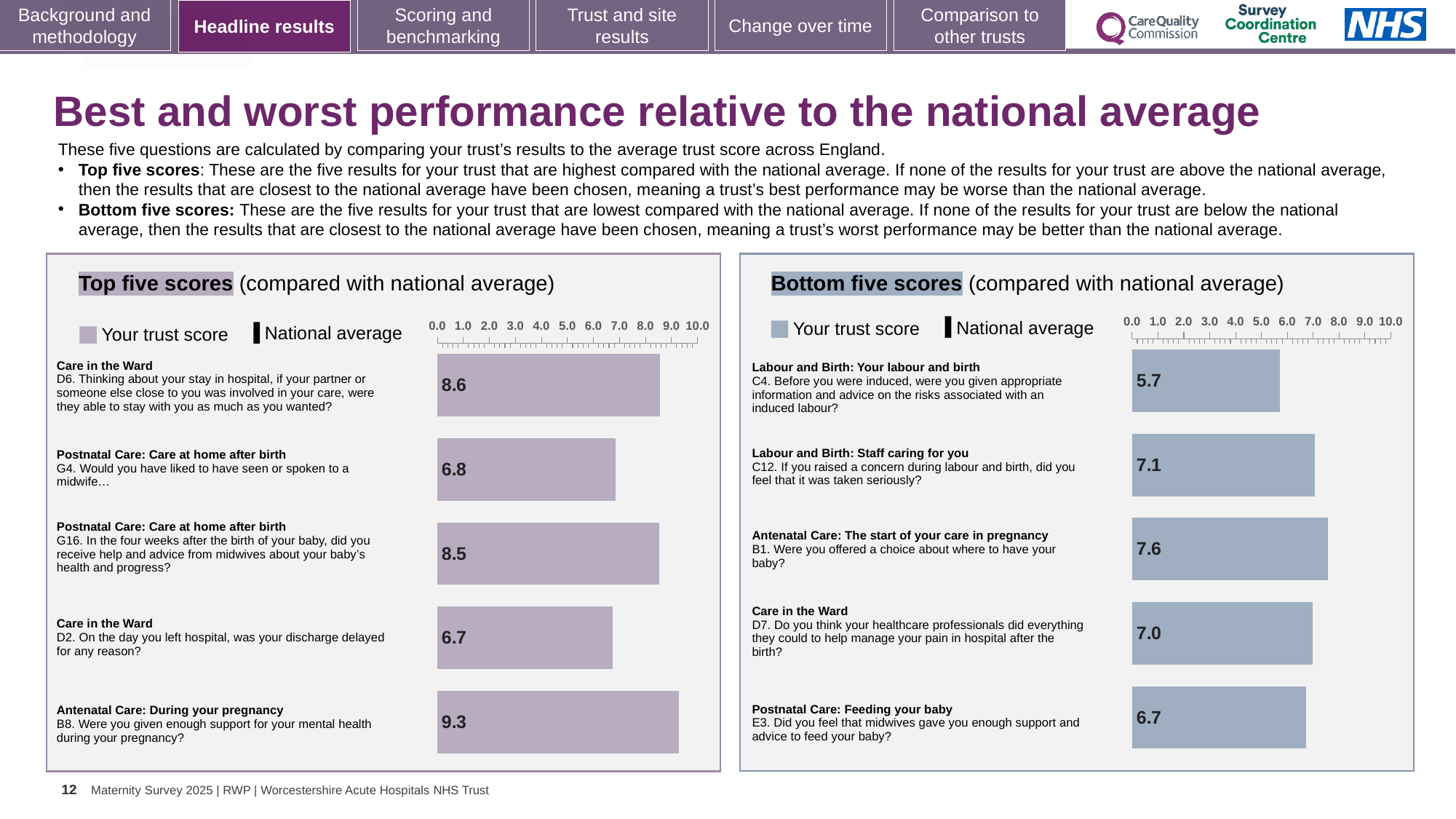
How many series does the legend of the Top five scores chart list? 2 What type of chart is used in the Bottom five scores panel? Bar chart In the Bottom five scores chart, what is the trust score for question C4 about information on the risks of induced labour? 5.7 In the Top five scores chart, what is the trust score for question B8 about support for mental health during pregnancy? 9.3 In the Top five scores chart, which question has the highest trust score? B8. Were you given enough support for your mental health during your pregnancy? In the Bottom five scores chart, which has the larger trust score: C12 or D7? C12 In the Bottom five scores chart, what is the trust score for question E3 about support and advice to feed your baby? 6.7 In the Bottom five scores chart, what is the difference between the trust scores for B1 and C4? 1.9 In the Top five scores chart, what is the trust score for question D6 about a partner being able to stay with you in hospital? 8.6 In the Bottom five scores chart, which question has the lowest trust score? C4. Before you were induced, were you given appropriate information and advice on the risks associated with an induced labour? In the Top five scores chart, what is the difference between the trust scores for B8 and D2? 2.6 How many questions are shown in the Top five scores chart? 5